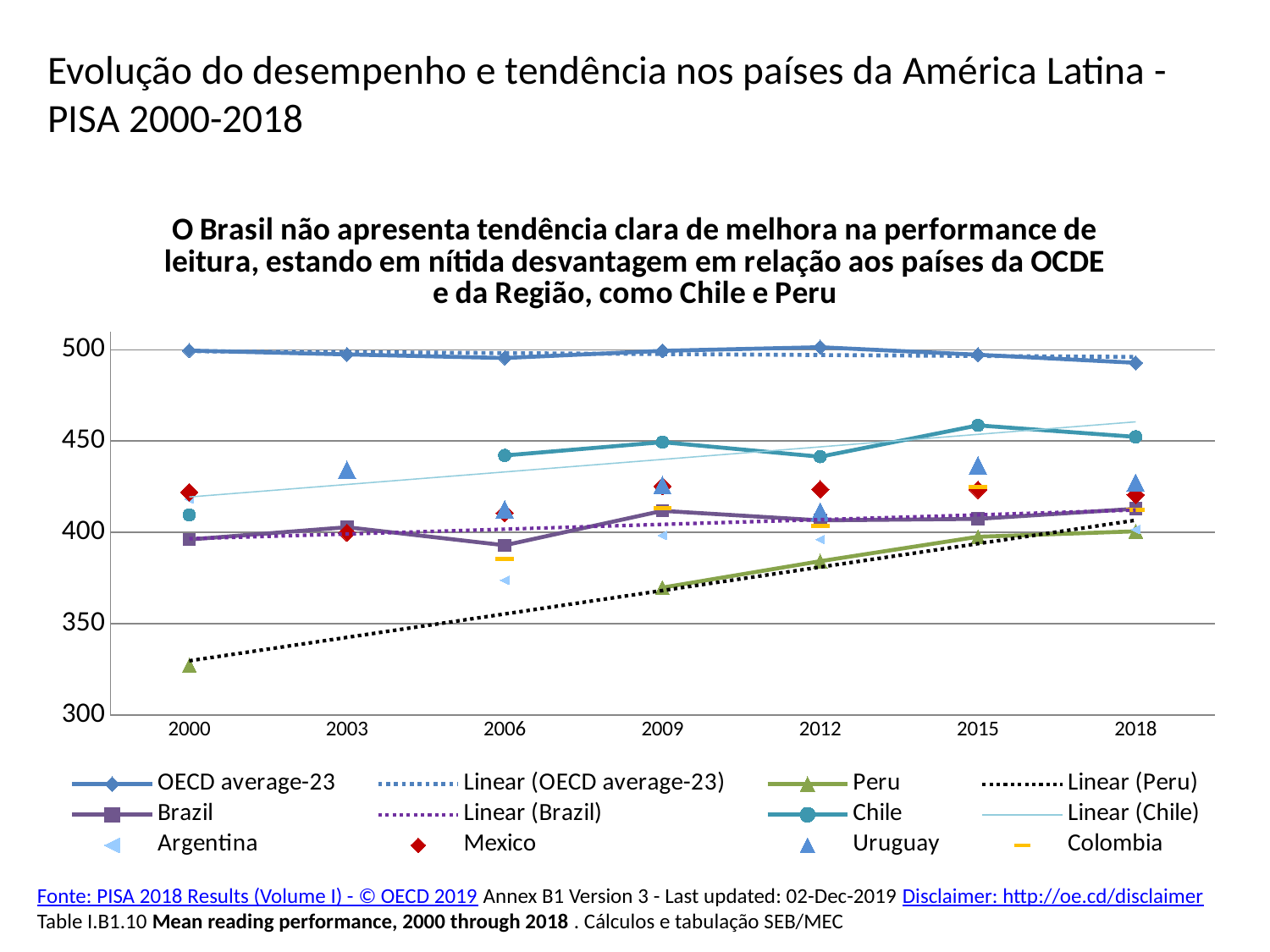
What kind of chart is shown on the slide? line chart Is the value for Uruguay in 2003 greater or less than 400? greater Is the value for Chile in 2015 greater or less than 450? greater Is the value for Brazil in 2006 greater or less than 400? less Which country has the lowest value in 2000? Peru How many years are shown on the x axis of the chart? 7 Which is higher in 2018, Chile or Brazil? Chile In which year does Chile reach its highest value? 2015 Do the values for Peru rise or fall from 2000 to 2018? rise How many entries does the chart legend list? 12